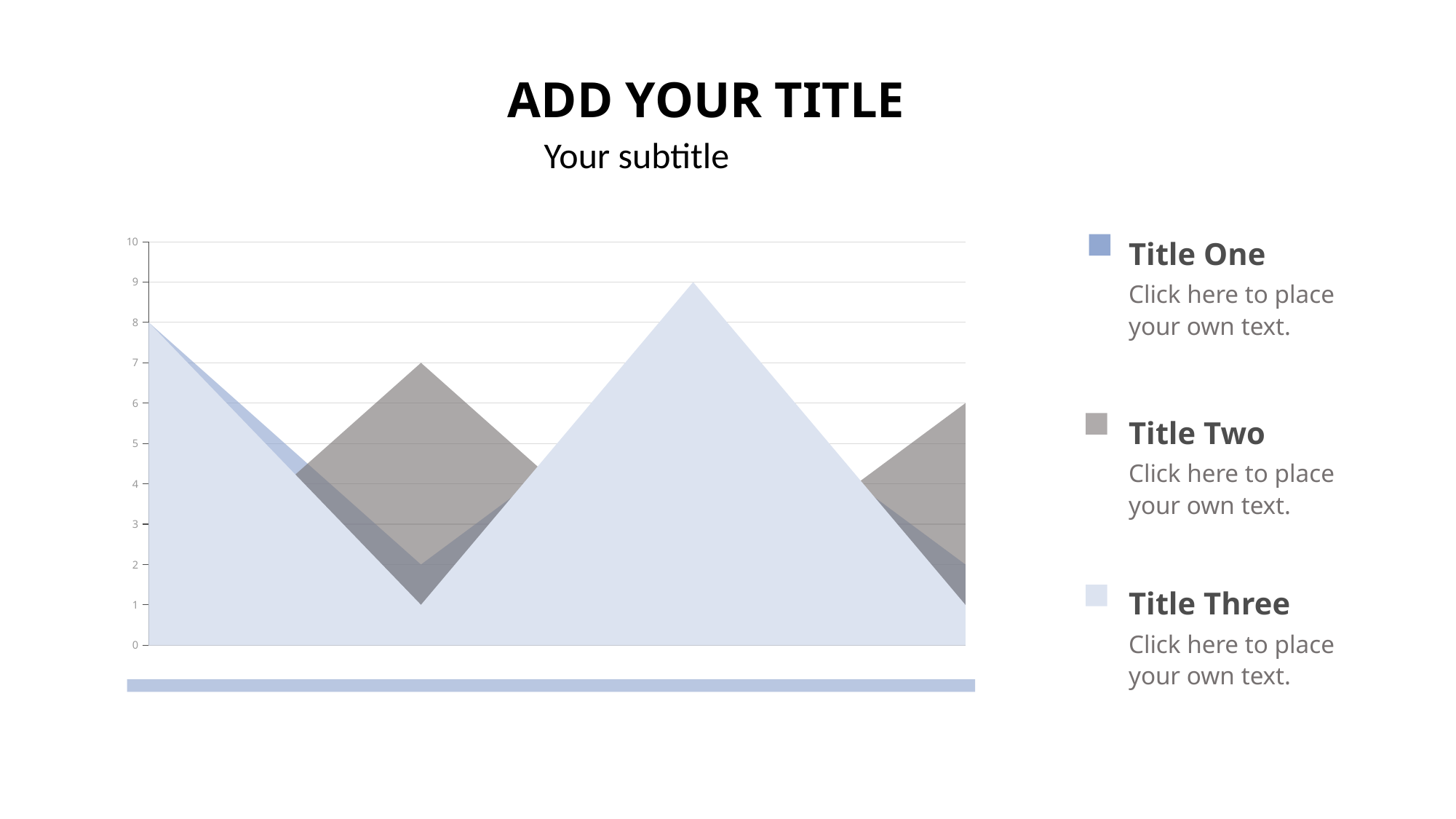
How many series does the legend list? 3 Which series reaches the highest value on the chart? Title Three Is the peak value of the Title Three series greater or less than 8? greater Which series has the higher peak, Title Two or Title Three? Title Three Does the Title Three series rise or fall between its first and second points? fall What kind of chart is shown on the slide? area chart What is the maximum value shown on the vertical axis? 10 Is the peak value of the Title Two series greater or less than 5? greater What is the highest value reached by the Title Three series? 9 What are the names of the three series in the legend? Title One, Title Two, Title Three What is the highest value reached by the Title Two series? 7 Is the lowest value of the Title Three series greater or less than 3? less